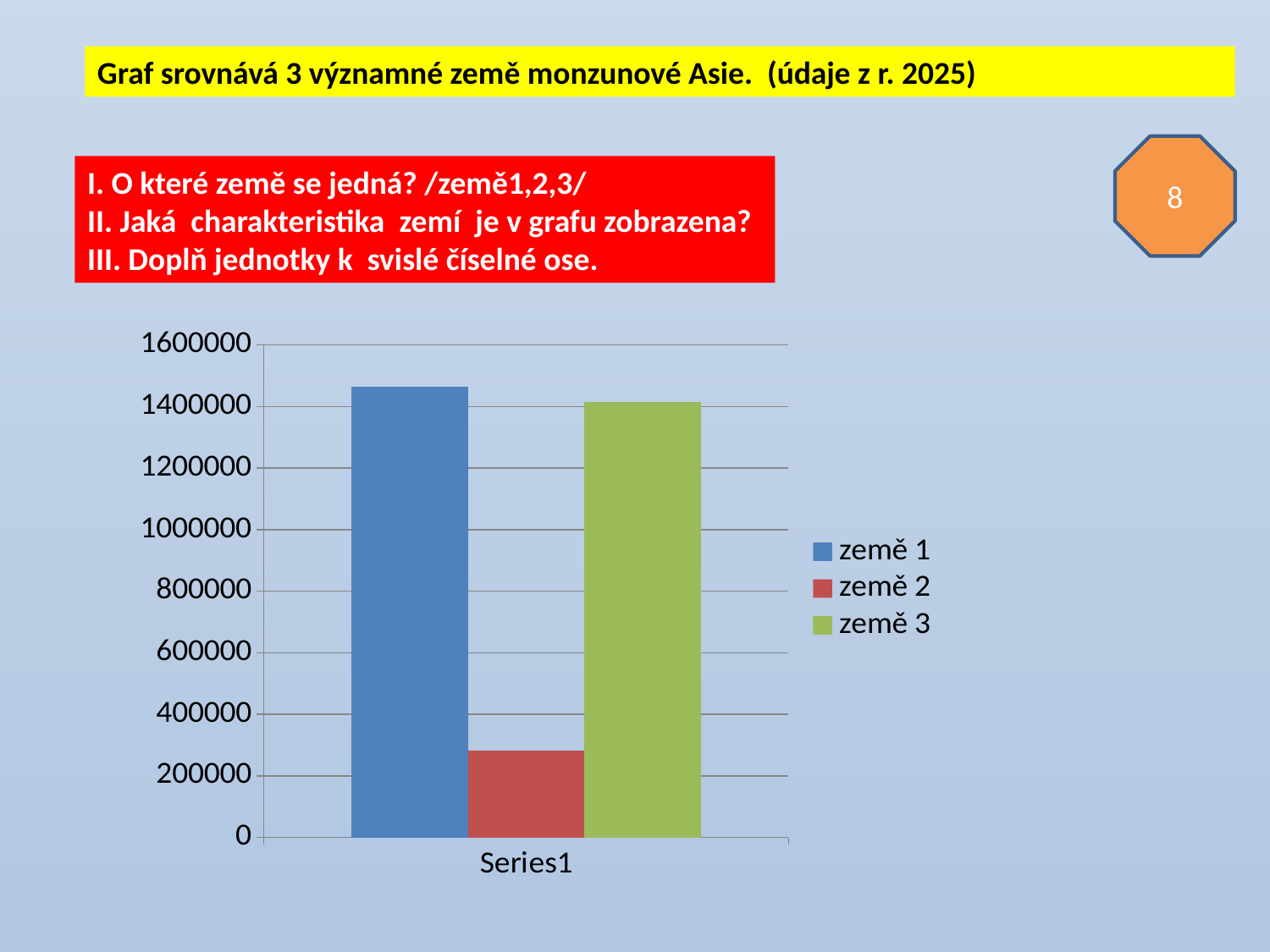
Which series has the shortest bar in the chart? země 2 Is the value for země 1 greater or less than 1400000? greater What colour is the bar for země 3 in the chart? green Which is larger, the value for země 1 or the value for země 2? země 1 Which series has the tallest bar in the chart? země 1 Which is larger, the value for země 2 or the value for země 3? země 3 What is the label shown on the horizontal axis of the chart? Series1 What kind of chart is shown on the slide? bar chart How many series does the chart legend list? 3 Is the value for země 2 greater or less than 200000? greater Is the value for země 2 greater or less than 400000? less